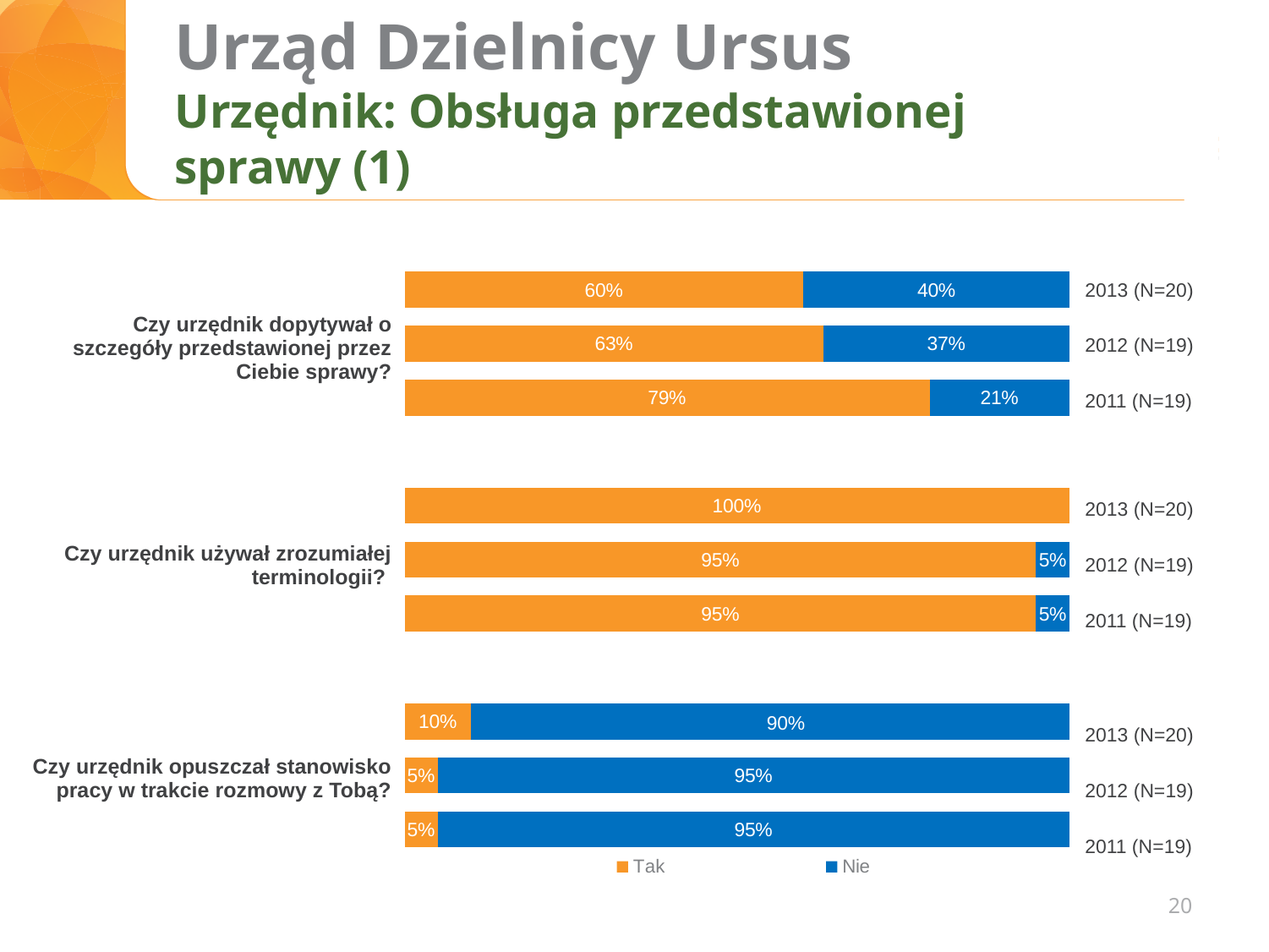
How many series does the legend list? 2 What percentage answered "Nie" in 2013 (N=20) to "Czy urzędnik opuszczał stanowisko pracy w trakcie rozmowy z Tobą?"? 90% What percentage answered "Nie" in 2011 (N=19) to "Czy urzędnik dopytywał o szczegóły przedstawionej przez Ciebie sprawy?"? 21% How does the "Tak" share for "Czy urzędnik dopytywał o szczegóły przedstawionej przez Ciebie sprawy?" change from 2011 to 2013? It falls What kind of chart is shown on the slide? Stacked bar chart For "Czy urzędnik opuszczał stanowisko pracy w trakcie rozmowy z Tobą?", is the "Tak" share larger in 2013 (N=20) or in 2012 (N=19)? 2013 (N=20) Which colour represents "Nie" in the chart? Blue What is the difference between the "Tak" share in 2011 (N=19) and 2013 (N=20) for "Czy urzędnik dopytywał o szczegóły przedstawionej przez Ciebie sprawy?"? 19 percentage points For "Czy urzędnik dopytywał o szczegóły przedstawionej przez Ciebie sprawy?", which year has the highest "Tak" share? 2011 (N=19) For "Czy urzędnik dopytywał o szczegóły przedstawionej przez Ciebie sprawy?", which year has the lowest "Tak" share? 2013 (N=20) What percentage answered "Tak" in 2013 (N=20) to "Czy urzędnik dopytywał o szczegóły przedstawionej przez Ciebie sprawy?"? 60% What percentage answered "Tak" in 2013 (N=20) to "Czy urzędnik używał zrozumiałej terminologii?"? 100%